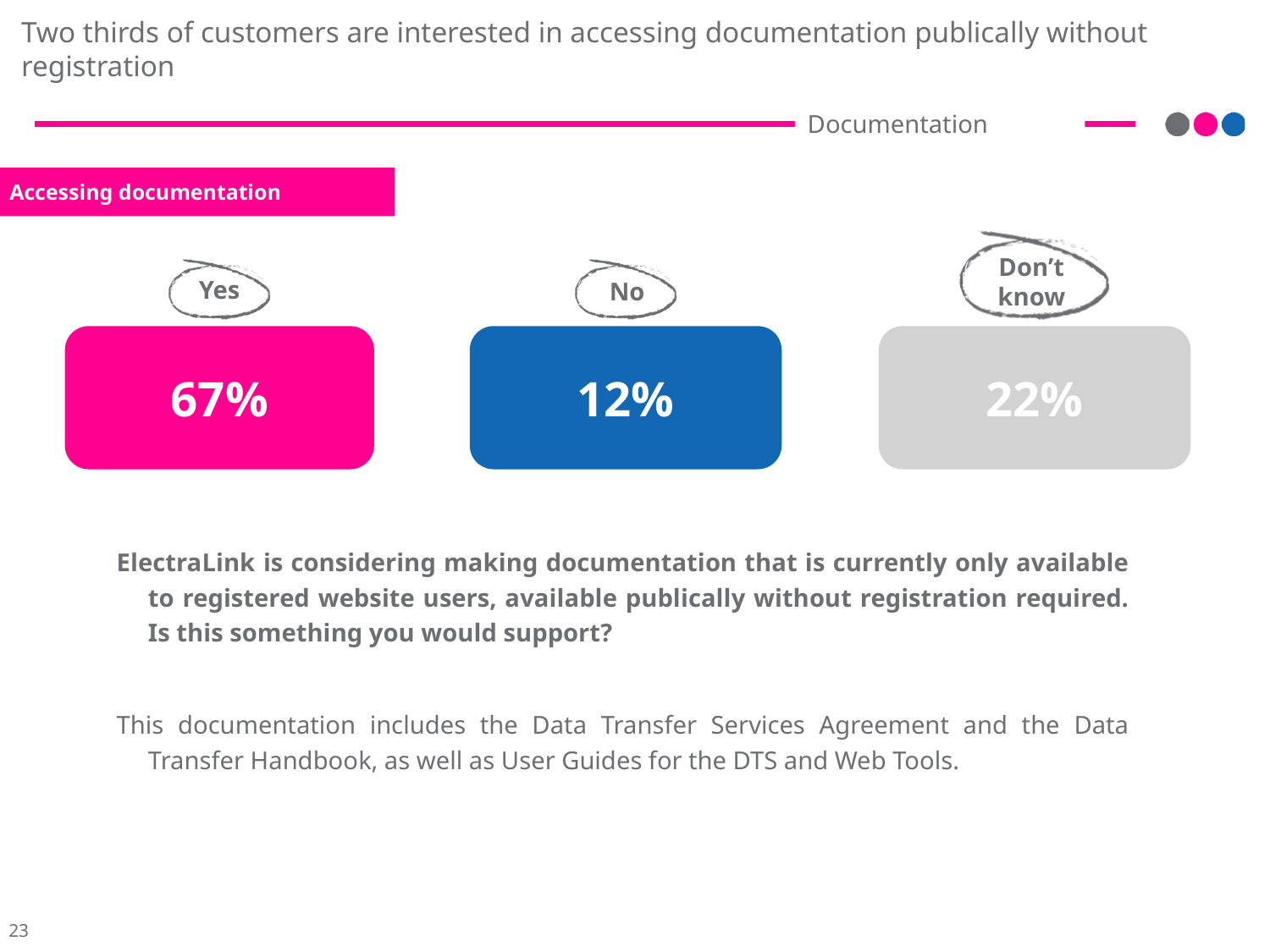
Which response option has the highest percentage? Yes How many response options are shown in the "Accessing documentation" visual? 3 What percentage of customers answered "Don't know"? 22% What colour is the box showing the "No" response? Blue What is the title of the visual showing the survey responses? Accessing documentation Which is larger, the share answering "Don't know" or the share answering "No"? Don't know Which response option has the lowest percentage? No What is the difference in percentage points between the "Don't know" and "No" responses? 10 What percentage of customers answered "No"? 12% What percentage of customers answered "Yes" to supporting public access to documentation without registration? 67% What is the difference in percentage points between the "Yes" and "No" responses? 55